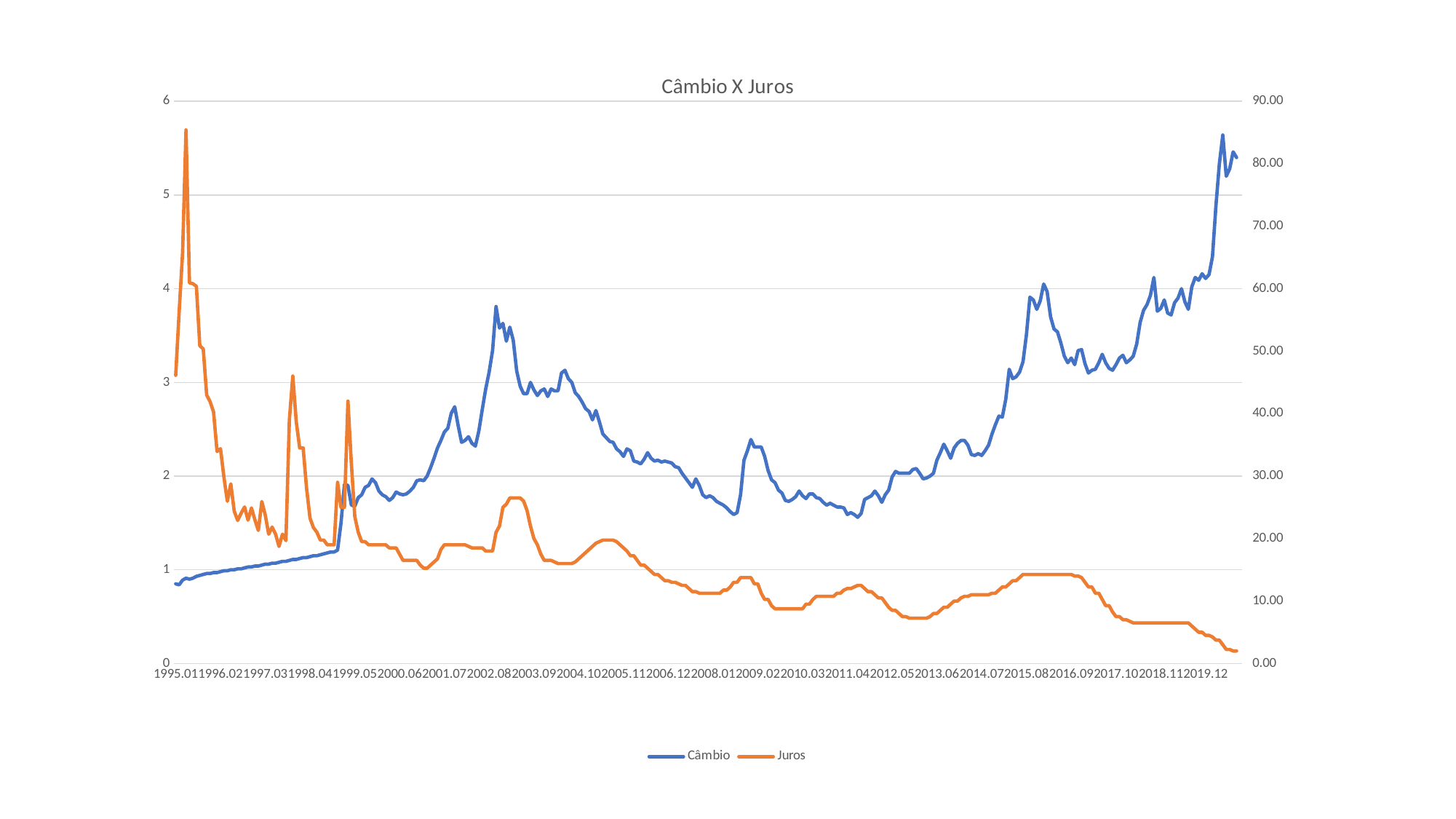
What is the title of the chart? Câmbio X Juros Around which x-axis label does the Juros series have its lowest value? 2019.12 What kind of chart is shown on the slide? line chart Which series reaches its highest value at the start of the period, near 1995.01? Juros How many series does the legend list? 2 Is the value for Câmbio at 2019.12 greater or less than 5? less Around which x-axis label does the Câmbio series have its lowest value? 1995.01 Is the value for Juros at 2015.08 greater or less than 20.00? less Around which x-axis label does the Câmbio series reach its highest value? 2019.12 Which colour is used for the Juros series? orange Overall, does the Juros series rise or fall from 1995.01 to 2019.12? fall